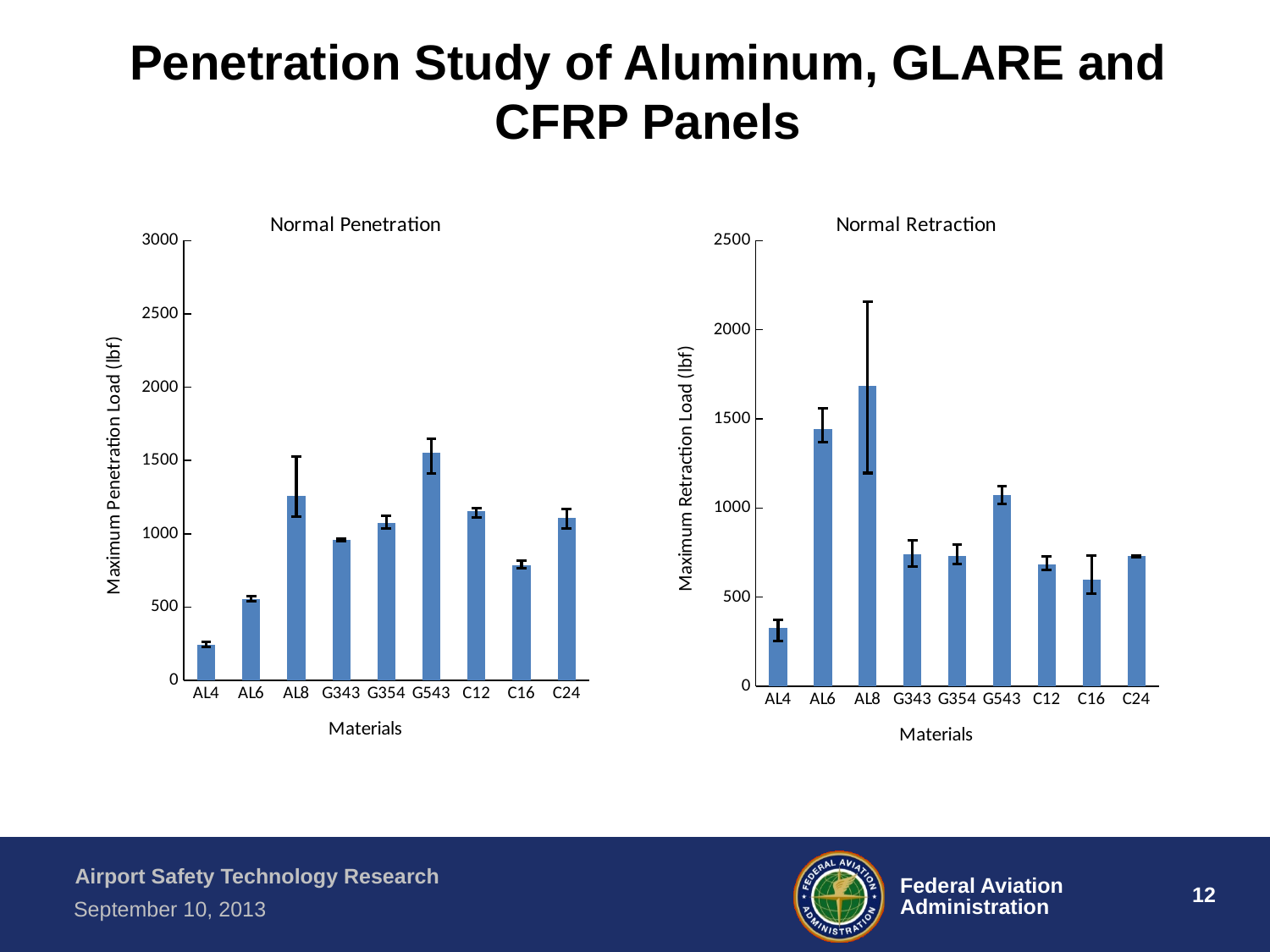
In the Normal Penetration chart, which is larger, the value for AL8 or the value for G343? AL8 In the Normal Retraction chart, is the value for AL6 greater or less than 1000? greater In the Normal Penetration chart, is the value for C16 greater or less than 1000? less In the Normal Retraction chart, which material has the highest maximum retraction load? AL8 In the Normal Penetration chart, which material has the lowest maximum penetration load? AL4 In the Normal Penetration chart, is the value for AL4 greater or less than 500? less How many materials are shown on the x axis of the Normal Penetration chart? 9 In the Normal Retraction chart, which material has the lowest maximum retraction load? AL4 In the Normal Retraction chart, which is larger, the value for AL6 or the value for G543? AL6 In the Normal Penetration chart, which material has the highest maximum penetration load? G543